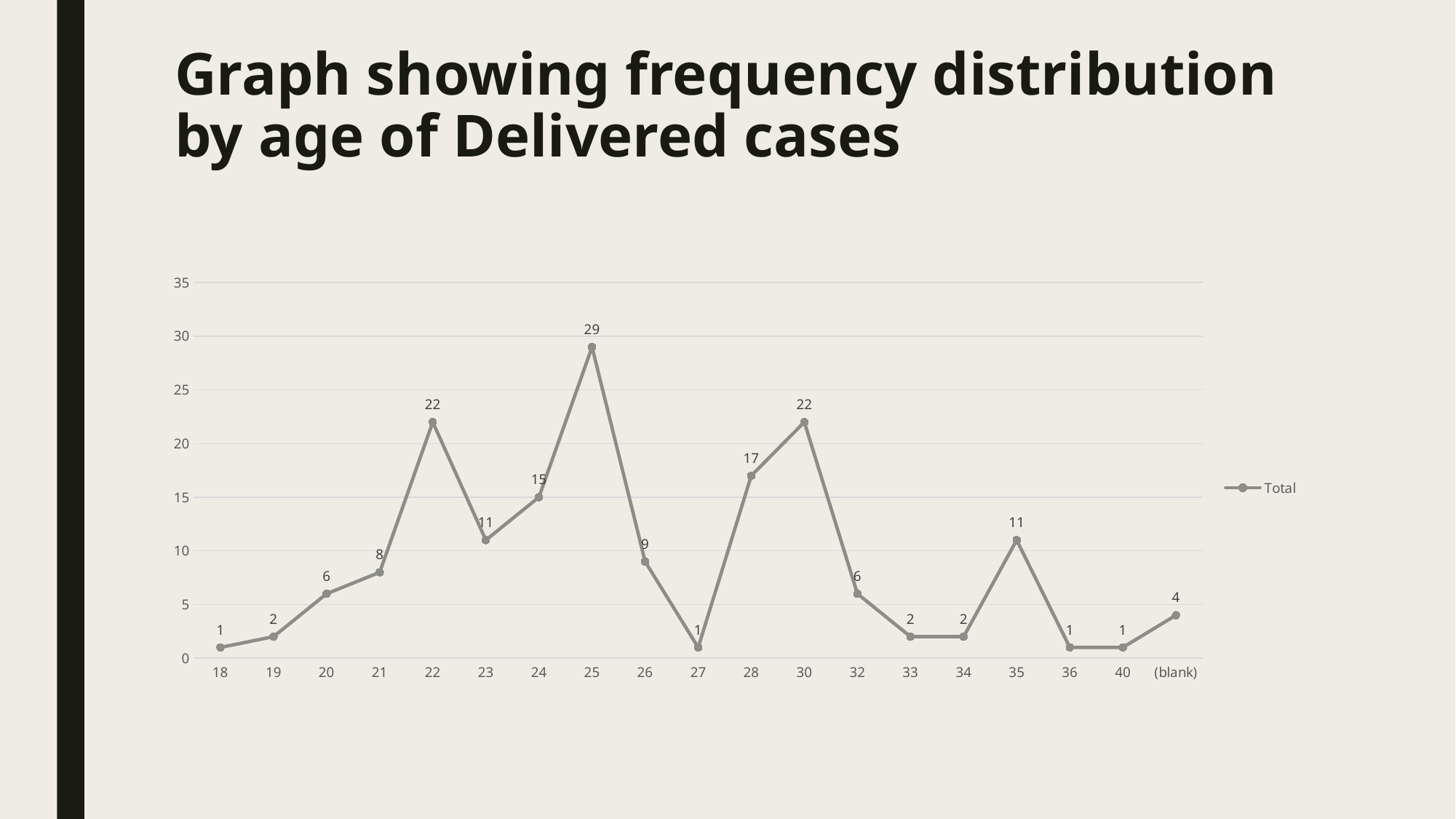
What is the value for age 28? 17 What is the lowest value plotted on the chart? 1 What type of chart is shown on the slide? line chart How many series does the legend list? 1 Which is larger, the value for age 24 or the value for age 23? age 24 What is the value for the (blank) category? 4 What is the value for age 35? 11 What is the value for age 25? 29 What is the name of the series shown in the legend? Total Which age has the highest value? 25 How many categories are plotted on the x axis? 19 What is the difference between the values for age 25 and age 22? 7